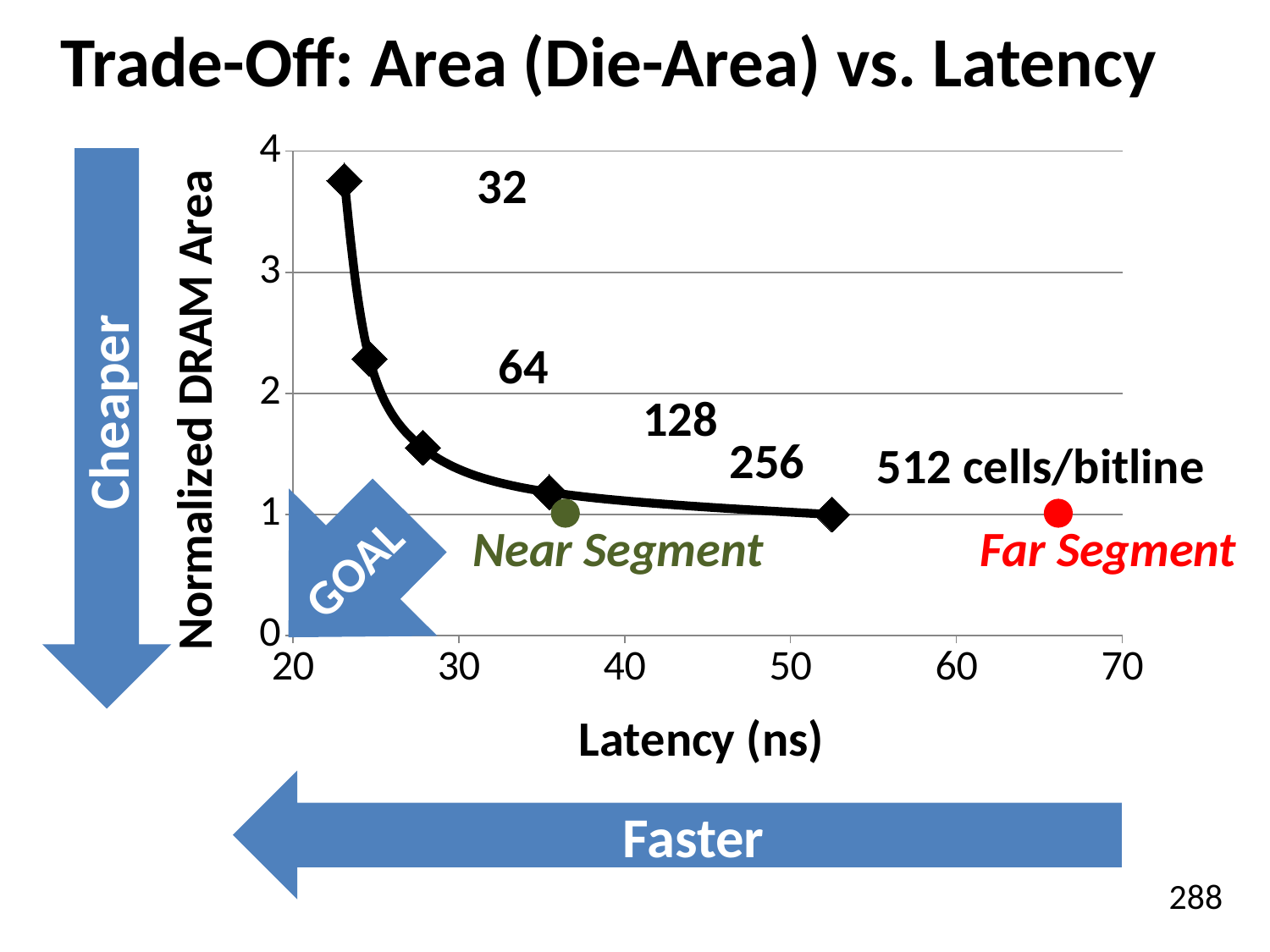
Is the latency of the Near Segment point greater or less than 40 ns? less What kind of chart is shown on the slide? line chart Which has the larger normalized DRAM area, 32 cells/bitline or 64 cells/bitline? 32 cells/bitline What is the title of the chart on the slide? Trade-Off: Area (Die-Area) vs. Latency What is the label of the x axis? Latency (ns) Is the normalized DRAM area for 32 cells/bitline greater or less than 3? greater Is the latency of the Far Segment point greater or less than 60 ns? greater Which cells/bitline configuration has the lowest latency? 32 Which cells/bitline configuration has the highest normalized DRAM area? 32 How many cells/bitline configurations are plotted as points on the black curve? 5 As latency increases along the x axis, does the normalized DRAM area rise or fall? fall